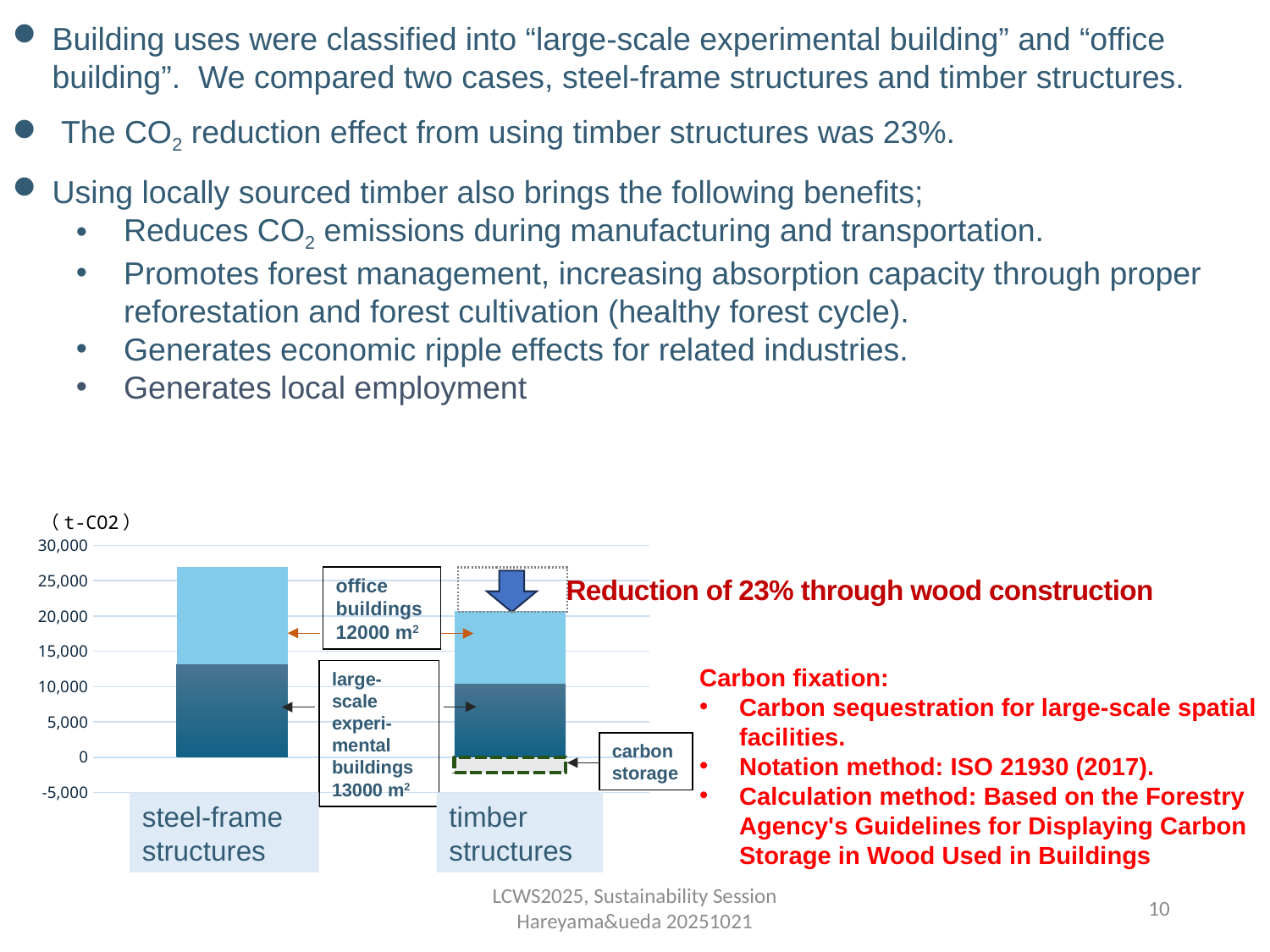
According to the annotation on the chart, what percentage reduction is achieved through wood construction? 23% Is the total value for timber structures greater or less than 15,000? greater Is the large-scale experimental buildings segment for timber structures greater or less than 15,000? less Is the total value for timber structures greater or less than 25,000? less What kind of chart is shown on the slide? stacked bar chart How many structure types (categories) are plotted on the x axis of the chart? 2 Do the total bar values rise or fall from steel-frame structures to timber structures? fall What unit is shown on the vertical axis of the chart? t-CO2 Which structure type has the taller total bar, steel-frame structures or timber structures? steel-frame structures